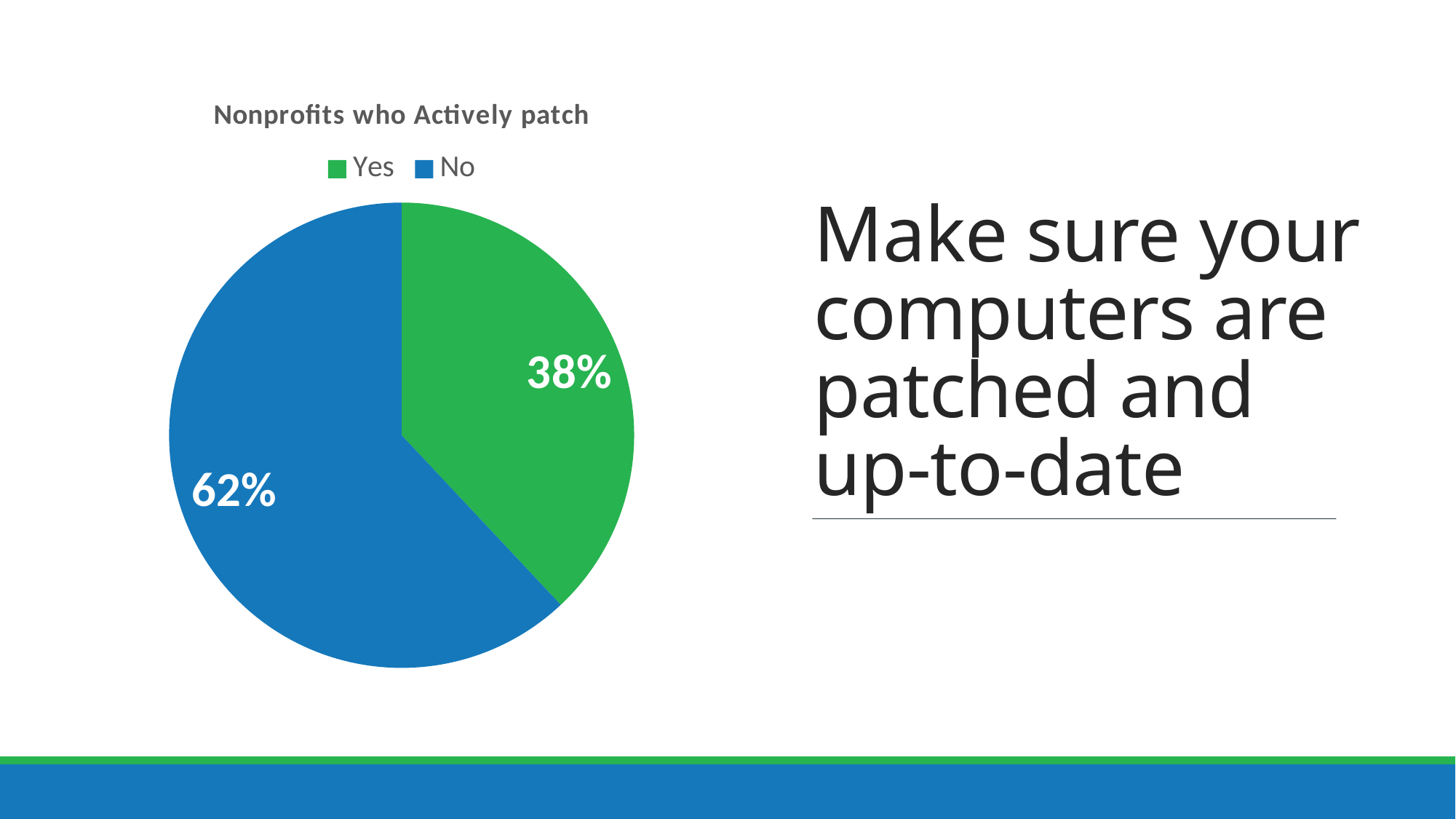
What colour is the Yes slice? green What percentage of nonprofits answered No to actively patching? 62% How many entries does the legend list? 2 What share of the pie does the No slice represent? 62% How many slices does the pie chart have? 2 What is the difference in percentage points between the No and Yes slices? 24 What is the title of the chart? Nonprofits who Actively patch Which is larger, the Yes slice or the No slice? No What percentage of nonprofits answered Yes to actively patching? 38% Which slice of the pie is the largest? No Which slice of the pie is the smallest? Yes What kind of chart is shown on the slide? pie chart